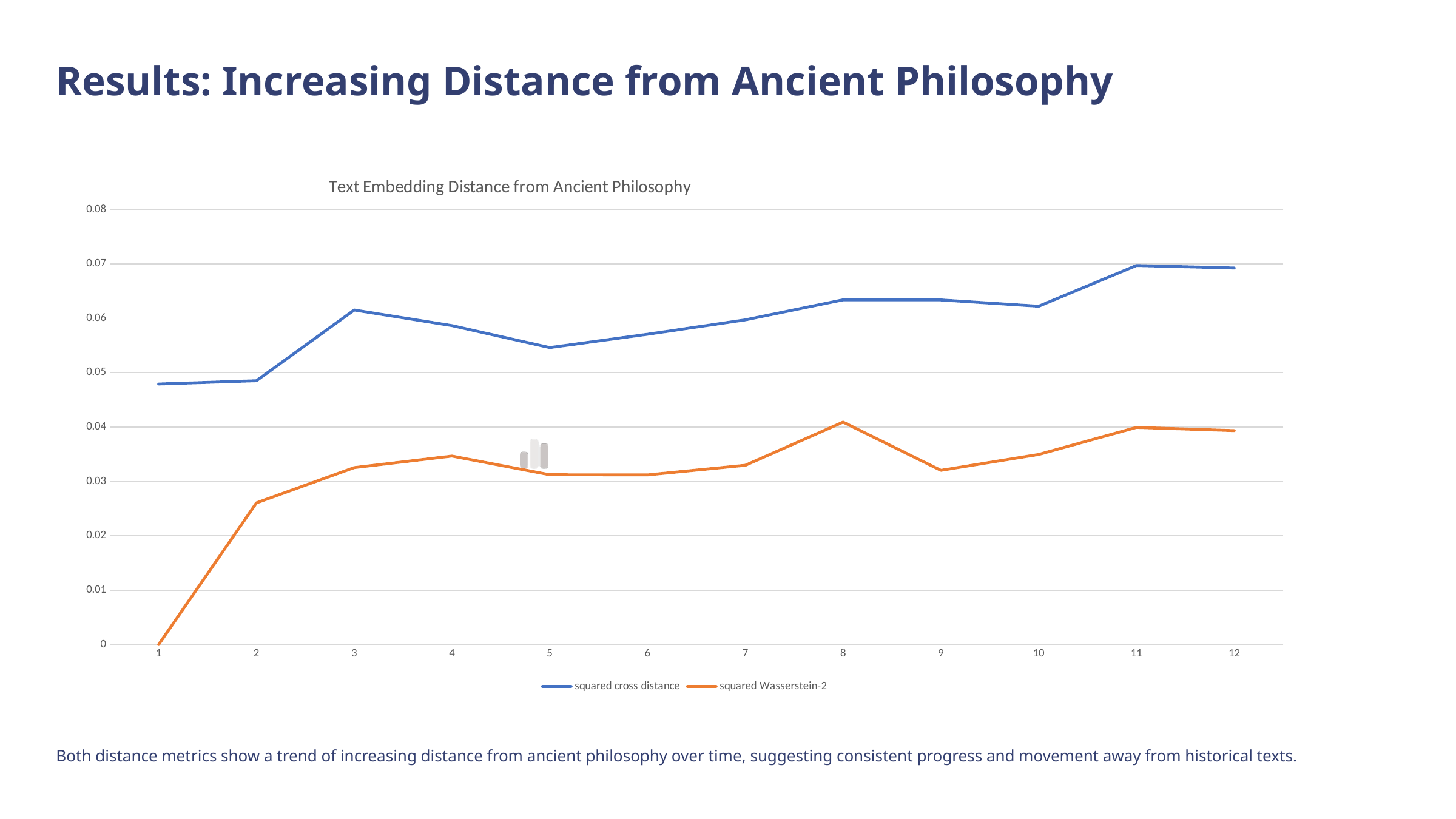
Is the value of squared Wasserstein-2 at x = 2 greater or less than 0.02? greater What is the value of squared Wasserstein-2 at x = 1? 0 What is the title of the chart? Text Embedding Distance from Ancient Philosophy Is the value of squared cross distance at x = 5 greater or less than 0.06? less How many series does the legend list? 2 What kind of chart is shown on the slide? line chart Is the value of squared cross distance at x = 3 greater or less than 0.06? greater Overall, do the squared cross distance values rise or fall from x = 1 to x = 12? rise At which x value is squared Wasserstein-2 lowest? 1 At x = 8, which series has the larger value, squared cross distance or squared Wasserstein-2? squared cross distance How many points are plotted along the x axis for each series? 12